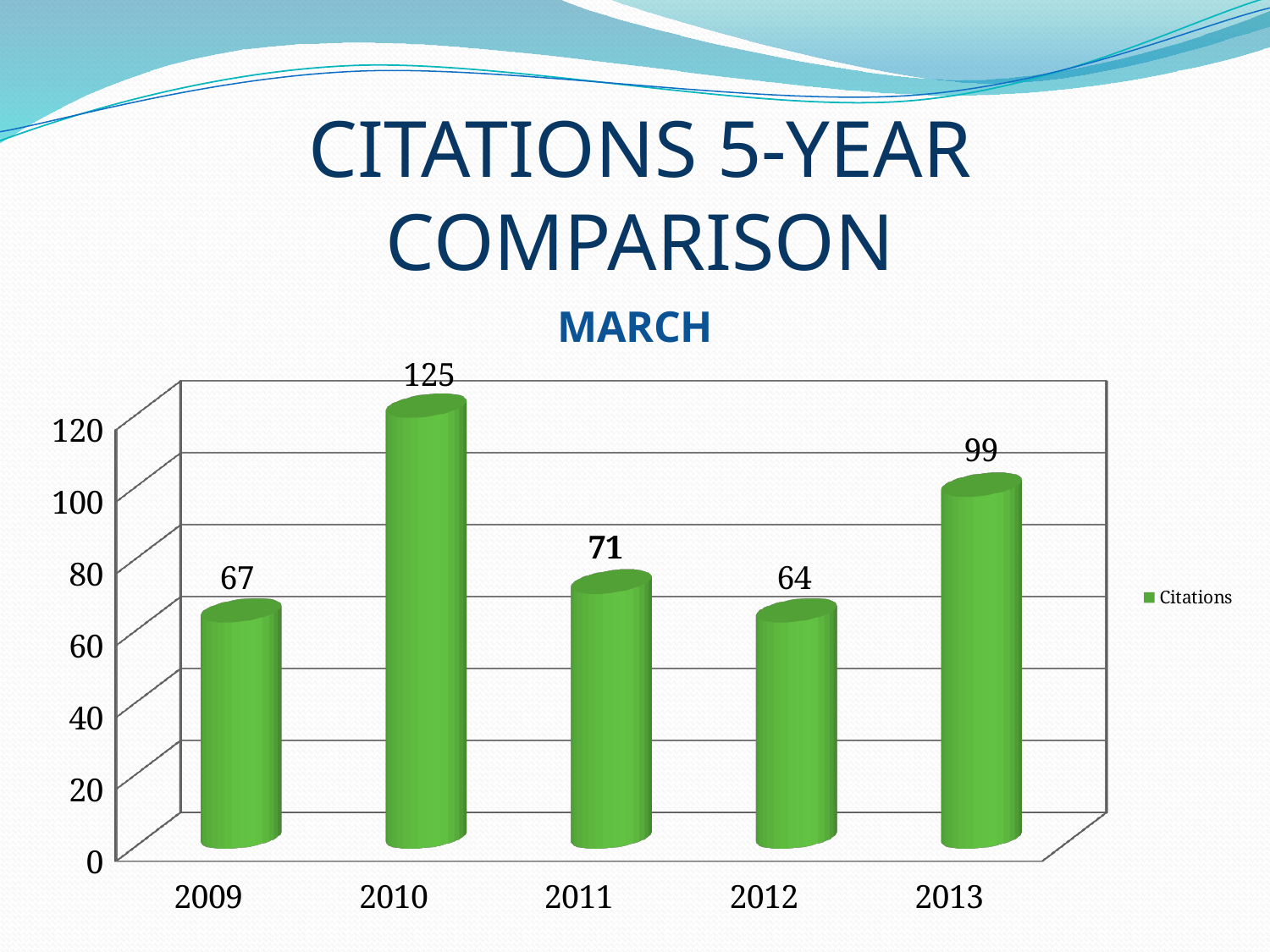
What is the number of citations for 2010? 125 Which year has the highest number of citations? 2010 What is the difference in citations between 2010 and 2013? 26 What kind of chart is shown on the slide? Bar chart How many years are shown on the x axis? 5 Is the value for 2011 greater or less than 80? less What is the number of citations for 2013? 99 Which year has more citations, 2009 or 2013? 2013 What is the title of the chart? MARCH What is the number of citations for 2012? 64 Which year has the lowest number of citations? 2012 What is the difference in citations between 2011 and 2009? 4